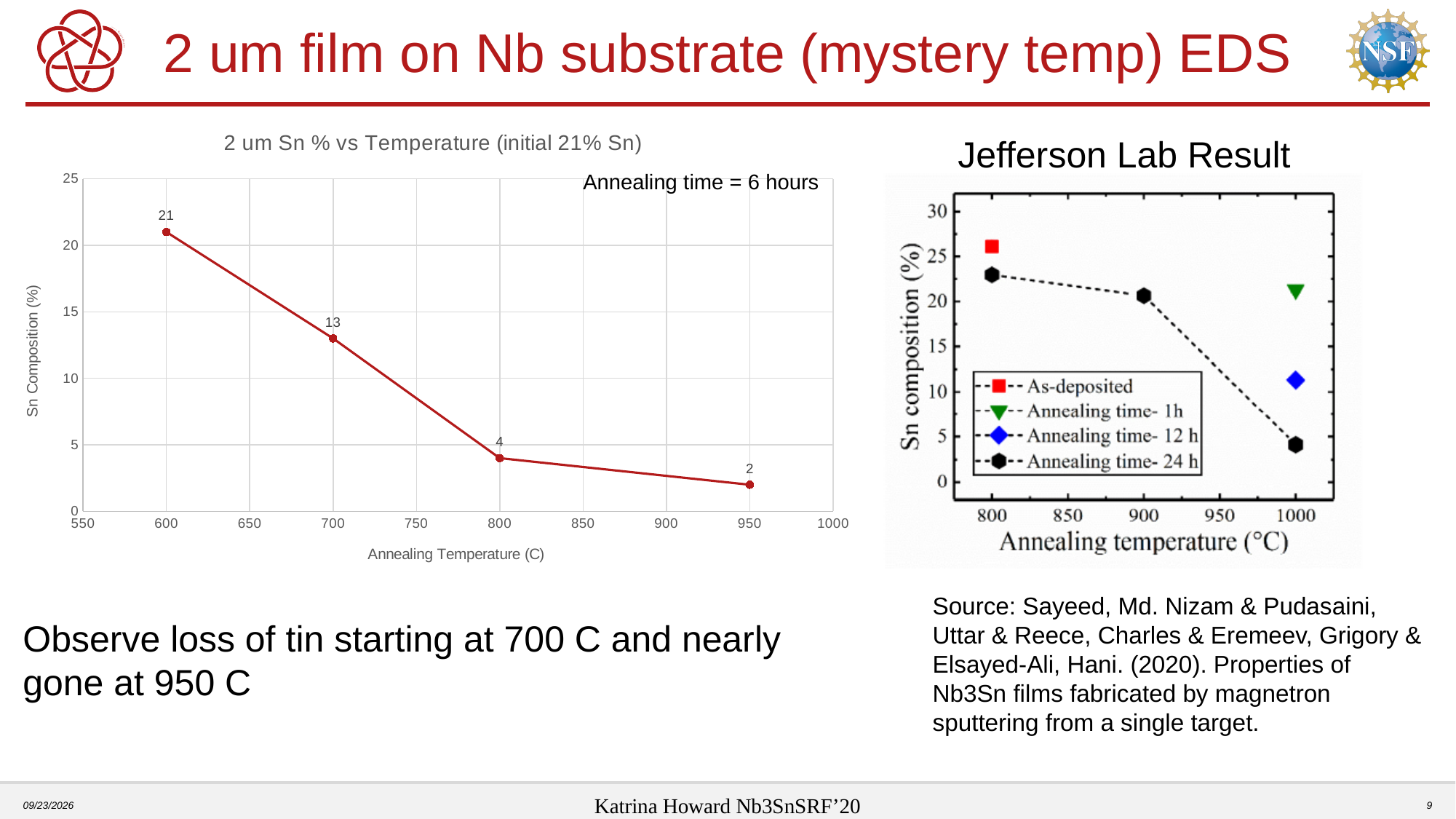
In the "Jefferson Lab Result" chart, how many series does the legend list? 4 In the chart titled "2 um Sn % vs Temperature (initial 21% Sn)", what is the Sn composition at 700 C? 13 In the chart titled "2 um Sn % vs Temperature (initial 21% Sn)", at which annealing temperature is the Sn composition highest? 600 In the chart titled "2 um Sn % vs Temperature (initial 21% Sn)", what is the Sn composition at an annealing temperature of 600 C? 21 In the chart titled "2 um Sn % vs Temperature (initial 21% Sn)", what is the difference in Sn composition between 600 C and 700 C? 8 In the chart titled "2 um Sn % vs Temperature (initial 21% Sn)", what is the difference in Sn composition between 800 C and 950 C? 2 In the chart titled "2 um Sn % vs Temperature (initial 21% Sn)", at which annealing temperature is the Sn composition lowest? 950 In the chart titled "2 um Sn % vs Temperature (initial 21% Sn)", does the Sn composition rise or fall as annealing temperature increases? fall In the chart titled "2 um Sn % vs Temperature (initial 21% Sn)", what is the Sn composition at 950 C? 2 In the "Jefferson Lab Result" chart, is the Sn composition for the Annealing time- 24 h series at 1000 C greater or less than 10? less What kind of chart is the one titled "2 um Sn % vs Temperature (initial 21% Sn)"? line chart In the chart titled "2 um Sn % vs Temperature (initial 21% Sn)", how many data points are plotted? 4